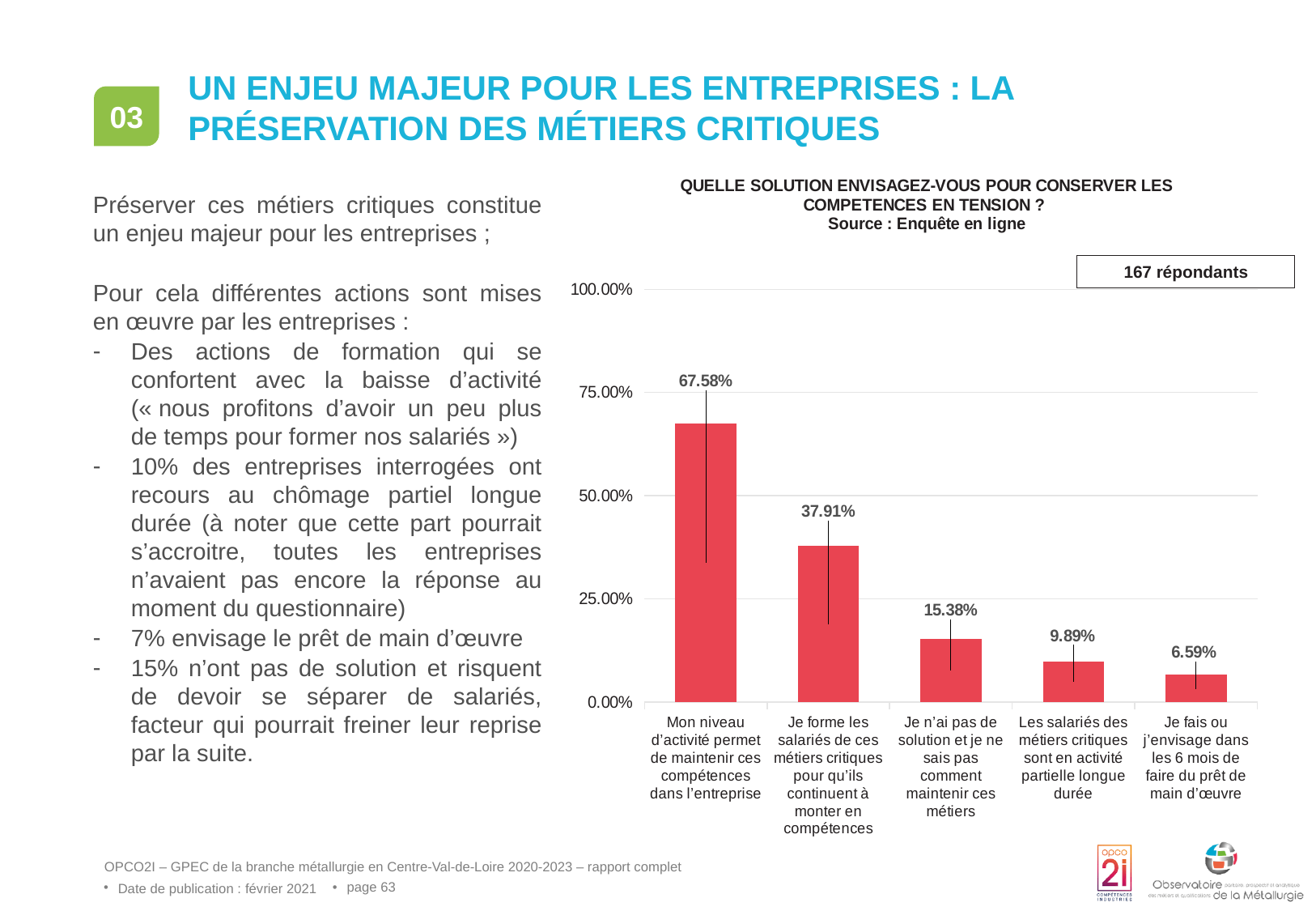
What is the value for "Je forme les salariés de ces métiers critiques pour qu'ils continuent à monter en compétences"? 37.91% How many respondents does the chart report? 167 répondants Which category has the highest value? Mon niveau d'activité permet de maintenir ces compétences dans l'entreprise Is the value for "Je forme les salariés de ces métiers critiques pour qu'ils continuent à monter en compétences" greater or less than 50.00%? less What is the difference between the values for "Mon niveau d'activité permet de maintenir ces compétences dans l'entreprise" and "Je forme les salariés de ces métiers critiques pour qu'ils continuent à monter en compétences"? 29.67% What kind of chart is shown on the slide? Bar chart Which is larger: the value for "Les salariés des métiers critiques sont en activité partielle longue durée" or the value for "Je n'ai pas de solution et je ne sais pas comment maintenir ces métiers"? Je n'ai pas de solution et je ne sais pas comment maintenir ces métiers What is the value for "Je fais ou j'envisage dans les 6 mois de faire du prêt de main d'œuvre"? 6.59% Which category has the lowest value? Je fais ou j'envisage dans les 6 mois de faire du prêt de main d'œuvre How many categories are shown in the chart? 5 What is the value for "Je n'ai pas de solution et je ne sais pas comment maintenir ces métiers"? 15.38% What is the value for "Mon niveau d'activité permet de maintenir ces compétences dans l'entreprise"? 67.58%